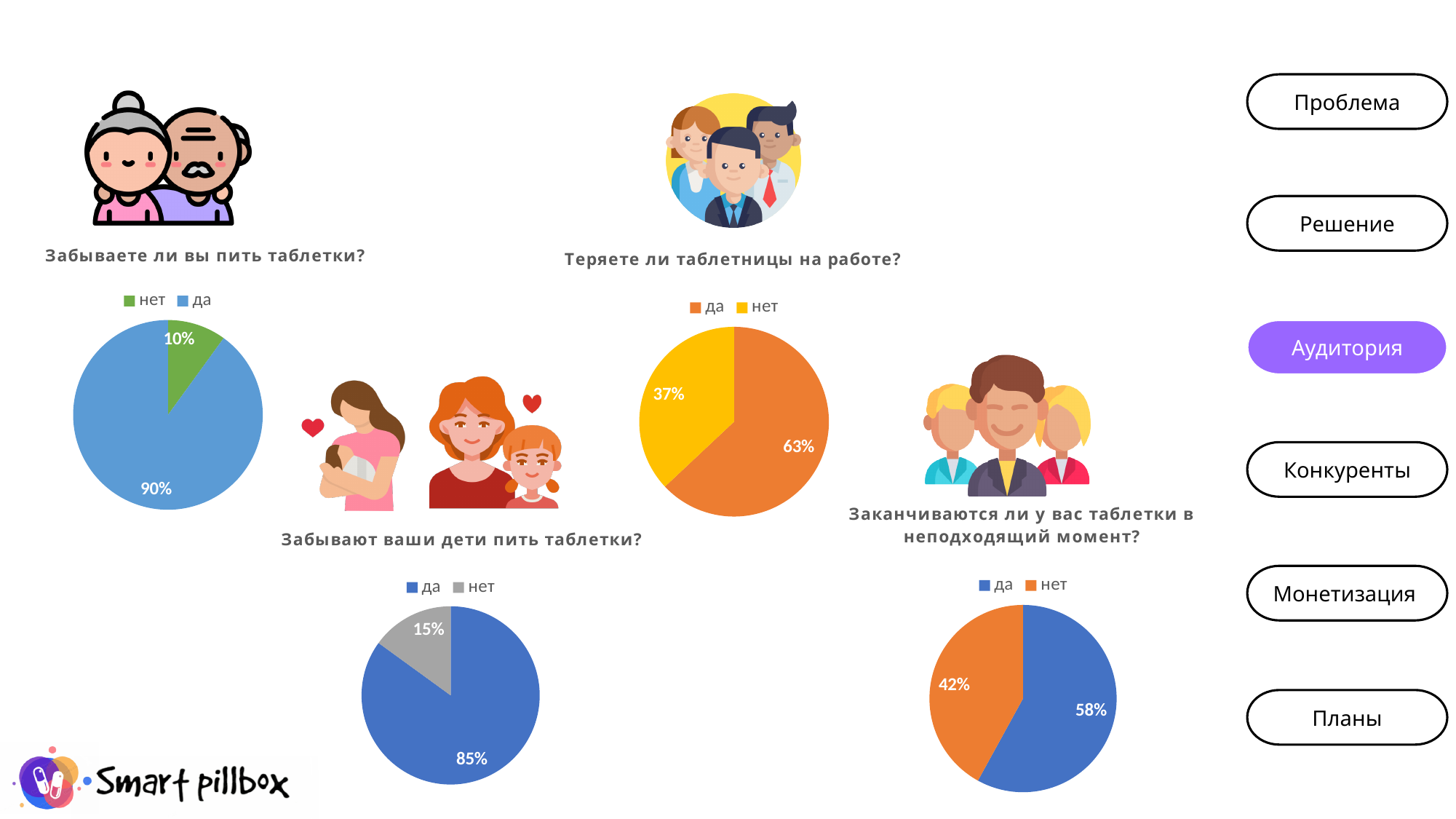
In the chart titled "Теряете ли таблетницы на работе?", what colour represents "нет"? Yellow In the chart titled "Забываете ли вы пить таблетки?", what share of respondents answered "да"? 90% What type of chart is used for "Забывают ваши дети пить таблетки?"? Pie chart In the chart titled "Теряете ли таблетницы на работе?", what is the value for "да"? 63% In the chart titled "Забывают ваши дети пить таблетки?", what is the value for "нет"? 15% In the chart titled "Заканчиваются ли у вас таблетки в неподходящий момент?", what is the value for "да"? 58% In the chart titled "Забываете ли вы пить таблетки?", what share of respondents answered "нет"? 10% In the chart titled "Теряете ли таблетницы на работе?", what is the value for "нет"? 37% In the chart titled "Теряете ли таблетницы на работе?", what is the difference between the "да" and "нет" shares? 26% In the chart titled "Заканчиваются ли у вас таблетки в неподходящий момент?", which answer has the larger share, "да" or "нет"? да In the chart titled "Забывают ваши дети пить таблетки?", what is the difference between the "да" and "нет" shares? 70% How many slices does the chart titled "Забываете ли вы пить таблетки?" have? 2